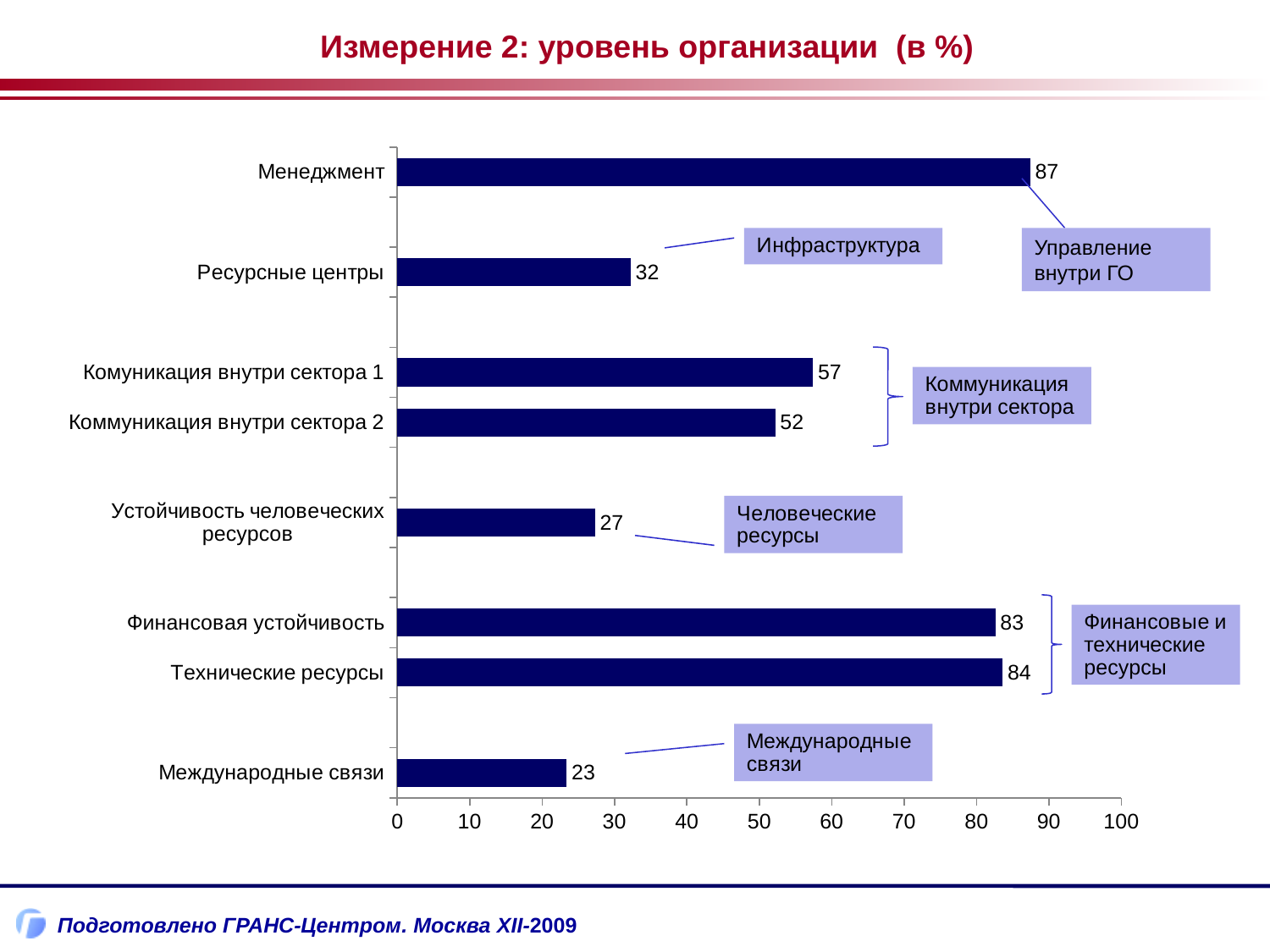
Which category has the highest value? Менеджмент Is the value for Технические ресурсы greater or less than 80? greater What is the difference between Менеджмент and Международные связи? 64 What is the value for Ресурсные центры? 32 Which is larger: Финансовая устойчивость or Устойчивость человеческих ресурсов? Финансовая устойчивость What is the value for Менеджмент? 87 What kind of chart is shown on the slide? bar chart What is the title of the chart on the slide? Измерение 2: уровень организации (в %) What is the difference between Комуникация внутри сектора 1 and Коммуникация внутри сектора 2? 5 Which category has the lowest value? Международные связи How many categories are plotted in the chart? 8 What is the value for Международные связи? 23